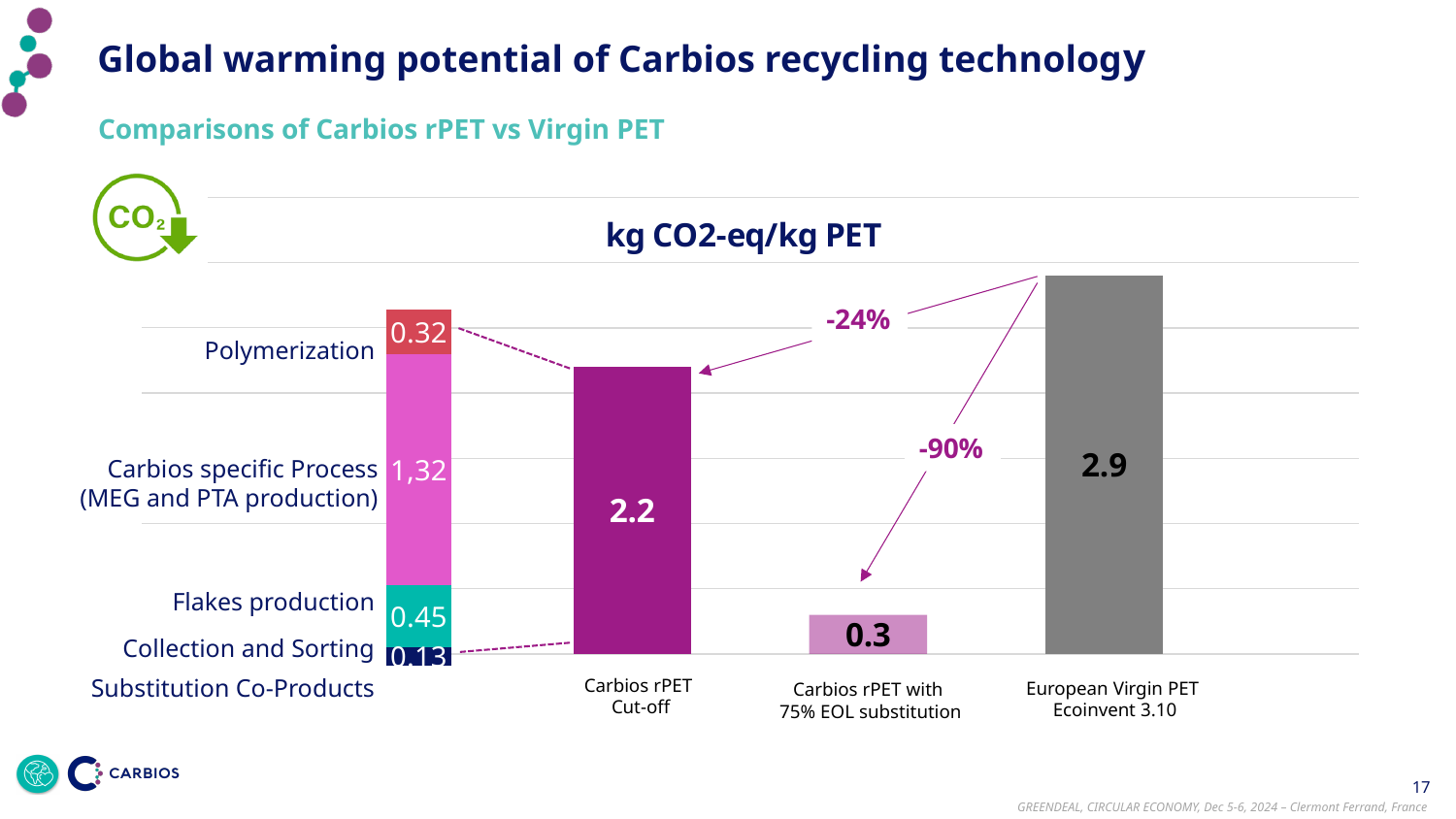
Which of the three labelled bars has the lowest value? Carbios rPET with 75% EOL substitution In the stacked breakdown bar, what is the value for Carbios specific Process (MEG and PTA production)? 1,32 In the stacked breakdown bar, what is the value for Flakes production? 0.45 What is the value for European Virgin PET Ecoinvent 3.10 in the kg CO2-eq/kg PET chart? 2.9 What kind of chart is shown on the slide? Bar chart In the stacked breakdown bar, what is the value for Polymerization? 0.32 Which is larger: the value for Carbios rPET Cut-off or the value for European Virgin PET Ecoinvent 3.10? European Virgin PET Ecoinvent 3.10 Which of the three labelled bars has the highest value? European Virgin PET Ecoinvent 3.10 What is the value for Carbios rPET with 75% EOL substitution? 0.3 What is the difference between the European Virgin PET value and the Carbios rPET Cut-off value? 0.7 What is the value for Carbios rPET Cut-off in the kg CO2-eq/kg PET chart? 2.2 What percentage reduction is shown between European Virgin PET and Carbios rPET with 75% EOL substitution? -90%